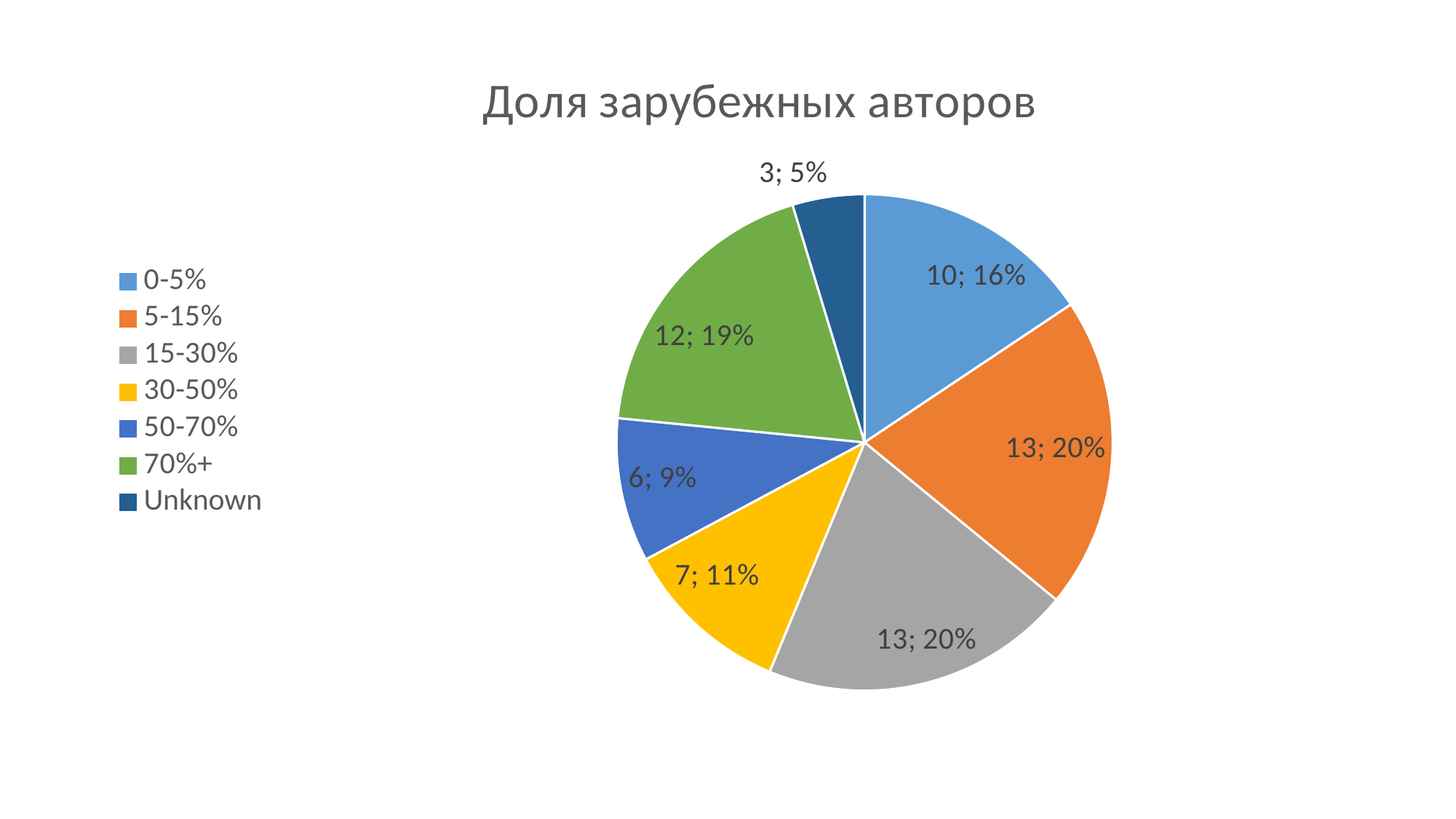
What is the count for the 0-5% category? 10 What is the difference between the counts for 5-15% and 30-50%? 6 How many slices does the pie chart have? 7 What share of the pie does the 70%+ slice represent? 19% Which is larger, the count for 0-5% or the count for 70%+? 70%+ What kind of chart is shown on the slide? pie chart Which category has the smallest slice? Unknown What share of the pie does the 50-70% slice represent? 9% What is the count for the Unknown category? 3 What is the count for the 30-50% category? 7 What is the title of the chart? Доля зарубежных авторов What colour is the slice for the 15-30% category? grey